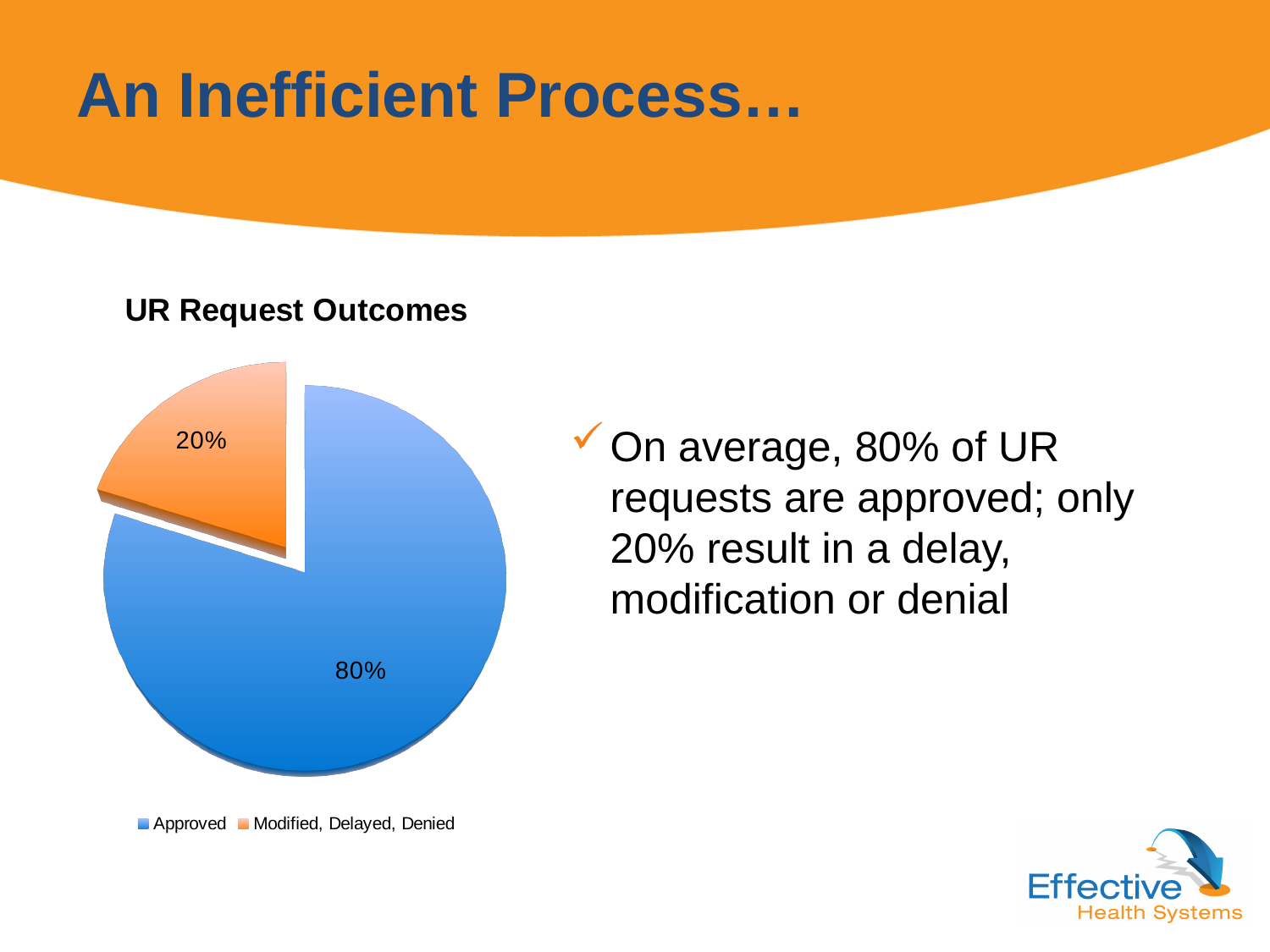
Which slice of the pie is the largest? Approved What is the difference in percentage points between the Approved slice and the Modified, Delayed, Denied slice? 60% What colour is the Approved slice? blue Which slice of the pie is the smallest? Modified, Delayed, Denied What share of UR request outcomes is Modified, Delayed, Denied? 20% What is the total of the two slices shown in the pie chart? 100% How many slices does the pie chart have? 2 What kind of chart is shown on the slide? pie chart What share of UR request outcomes is Approved? 80% Which is larger, the Approved slice or the Modified, Delayed, Denied slice? Approved How many entries does the legend list? 2 What is the title of the chart? UR Request Outcomes